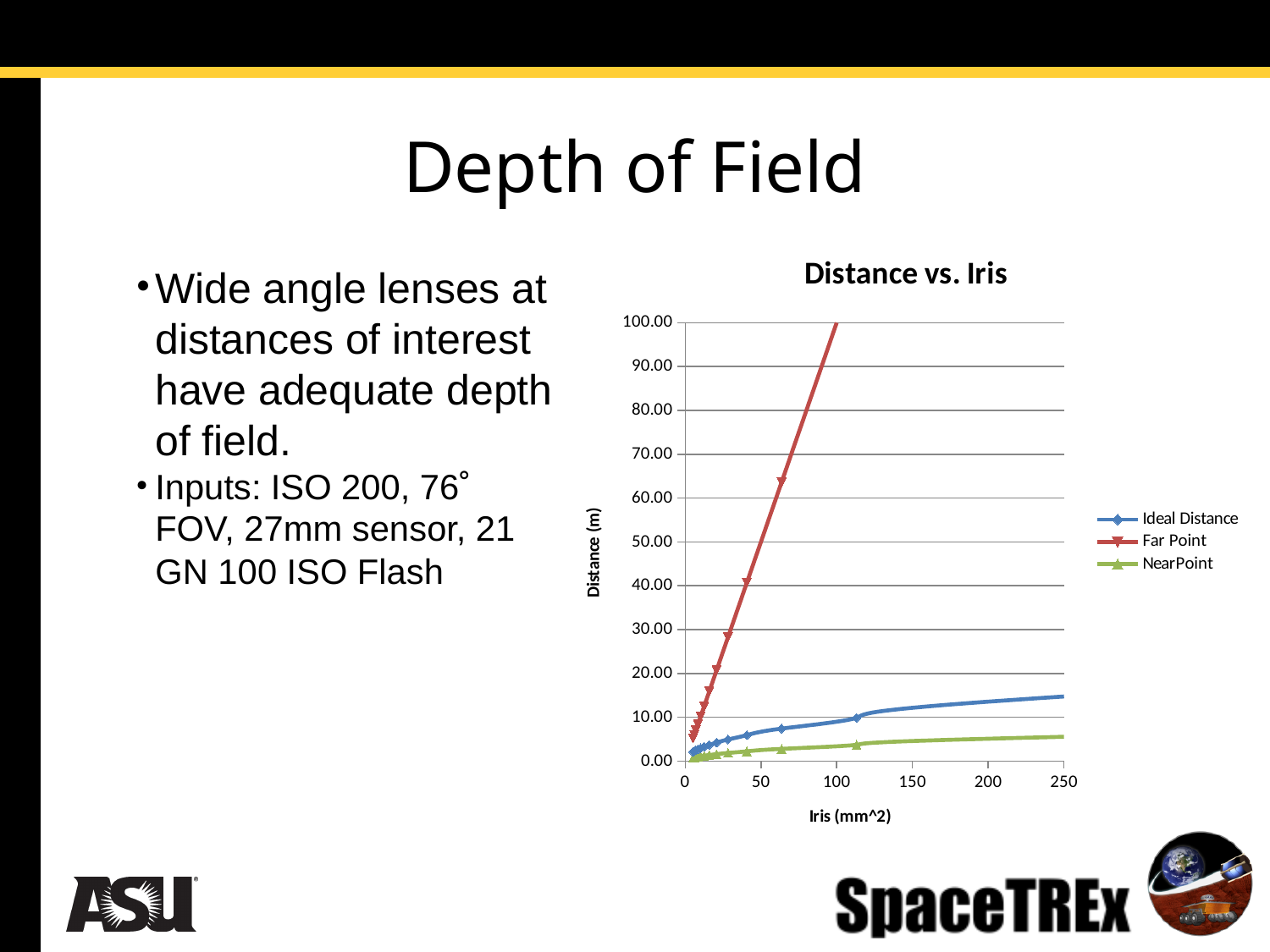
Is the NearPoint value at an Iris of 250 mm^2 greater or less than 10.00? less Which series has the lowest value at an Iris of 250 mm^2? NearPoint Does the Ideal Distance series rise or fall as Iris increases? rise Does the Far Point series rise or fall as Iris increases? rise Which series has the highest value at an Iris of 50 mm^2? Far Point What kind of chart is shown on the slide? line chart What is the label of the y axis of the chart? Distance (m) Is the Ideal Distance value at an Iris of 250 mm^2 greater or less than 20.00? less Is the Far Point value at an Iris of 50 mm^2 greater or less than 30.00? greater How many series does the legend of the chart list? 3 What is the title of the chart? Distance vs. Iris At an Iris of 100 mm^2, which is larger: Far Point or Ideal Distance? Far Point